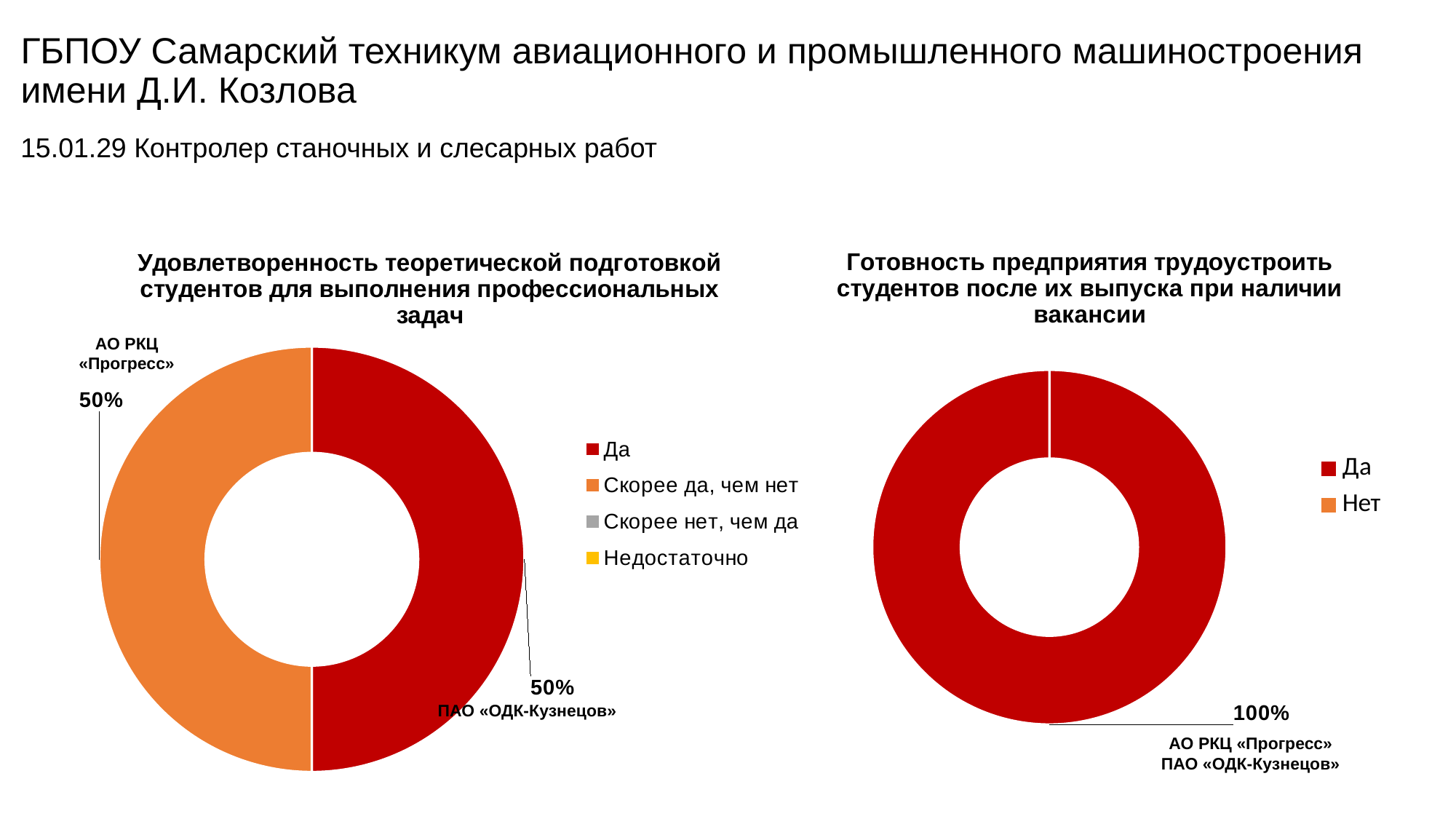
In the left chart, what share is labelled for the 'Да' slice? 50% How many entries does the legend of the right chart list? 2 In the left chart, what is the difference between the 'Да' share and the 'Скорее да, чем нет' share? 0% In the right chart, 'Готовность предприятия трудоустроить студентов после их выпуска при наличии вакансии', what share is labelled for the 'Да' slice? 100% In the right chart, which answer has the largest share? Да In the left chart, which enterprise is labelled next to the 'Да' slice? ПАО «ОДК-Кузнецов» In the right chart, is the share for 'Да' greater or less than 50%? greater In the left chart, which enterprise is labelled next to the 'Скорее да, чем нет' slice? АО РКЦ «Прогресс» How many entries does the legend of the left chart list? 4 What kind of chart is the right chart? Doughnut (pie) chart In the left chart, what share is labelled for the 'Скорее да, чем нет' slice? 50% What kind of chart is the left chart, 'Удовлетворенность теоретической подготовкой студентов для выполнения профессиональных задач'? Doughnut (pie) chart